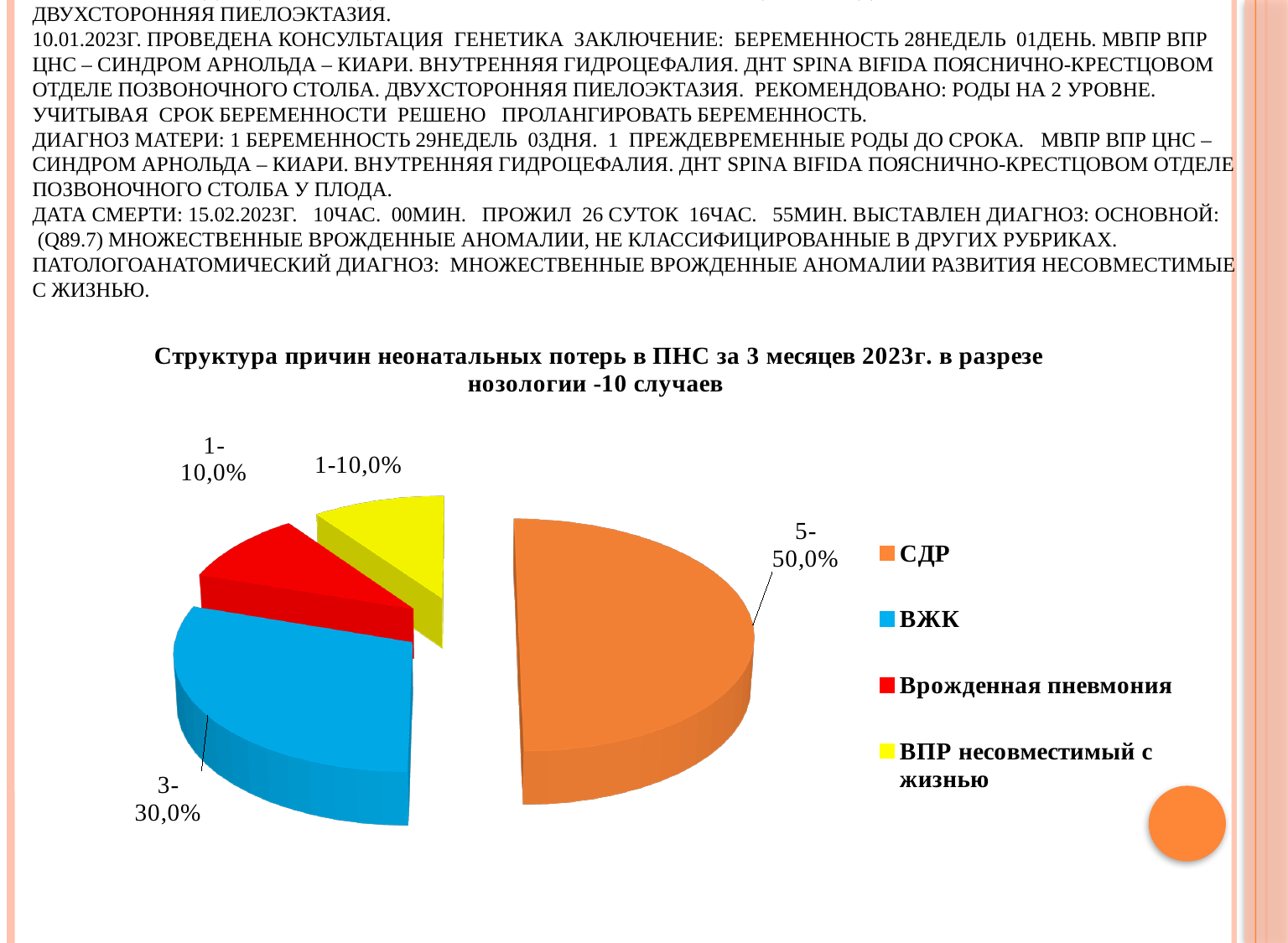
What is the difference in percentage points between the СДР share and the ВЖК share? 20,0% How many cases are attributed to СДР? 5 Which category has the largest share of the pie? СДР Which is larger, the share for ВЖК or the share for Врожденная пневмония? ВЖК How many cases are attributed to ВЖК? 3 What share of the pie does Врожденная пневмония account for? 10,0% What share of the pie does СДР account for? 50,0% What share of the pie does ВЖК account for? 30,0% What colour is the slice for ВПР несовместимый с жизнью? yellow How many categories does the legend list? 4 What kind of chart is shown on the slide? pie chart How many cases are attributed to ВПР несовместимый с жизнью? 1